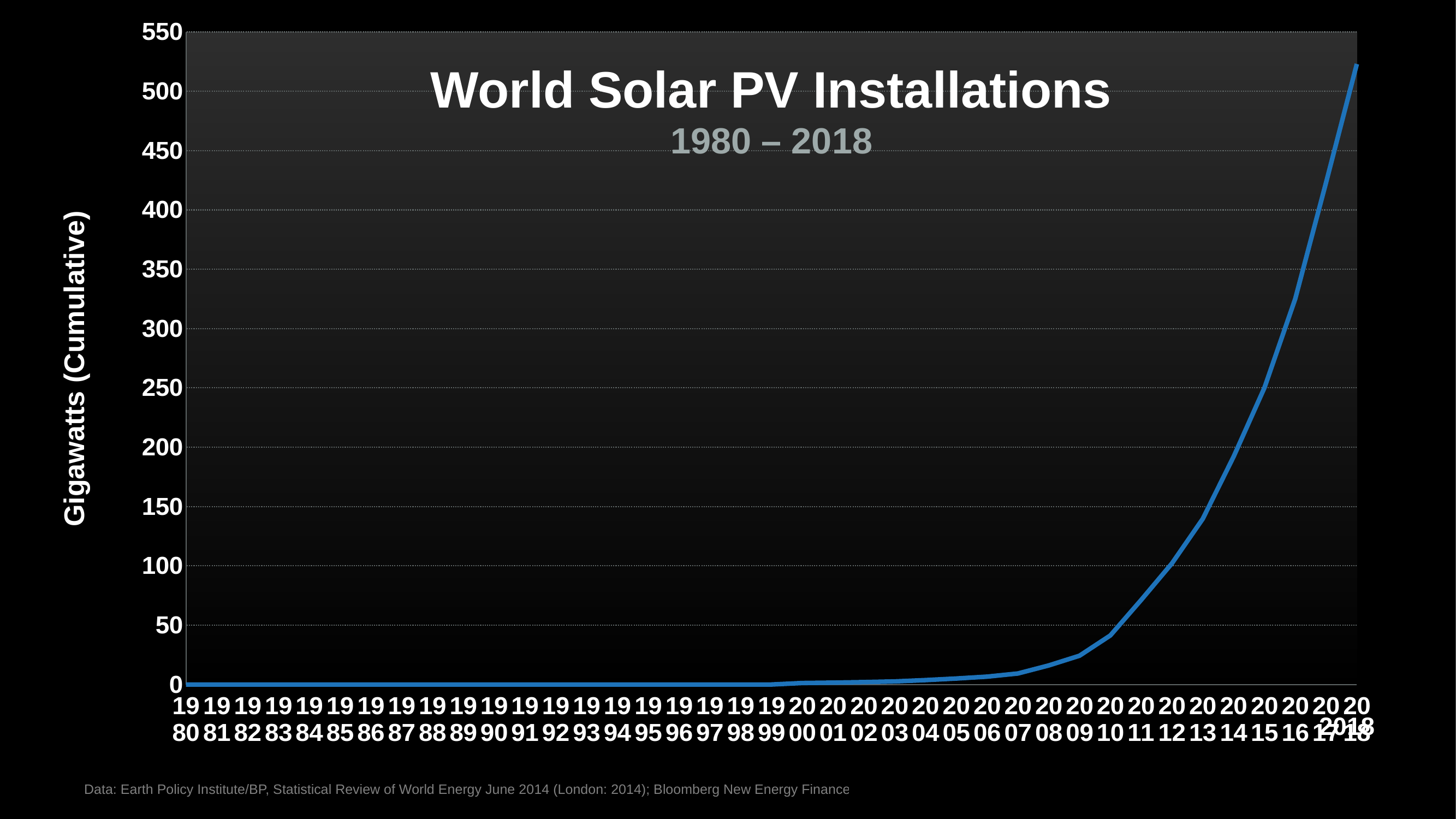
Do the values rise or fall along the x axis from 1980 to 2018? rise Is the value for 2000 greater or less than 50? less Is the value for 2010 greater or less than 50? less Is the value for 2011 greater or less than 100? less Which is larger, the value for 2018 or the value for 2010? 2018 What is the title of the chart? World Solar PV Installations Which year has the highest value on the chart? 2018 What is the label on the vertical axis of the chart? Gigawatts (Cumulative) What kind of chart is shown on the slide? line chart How many years are plotted on the x axis of the chart? 39